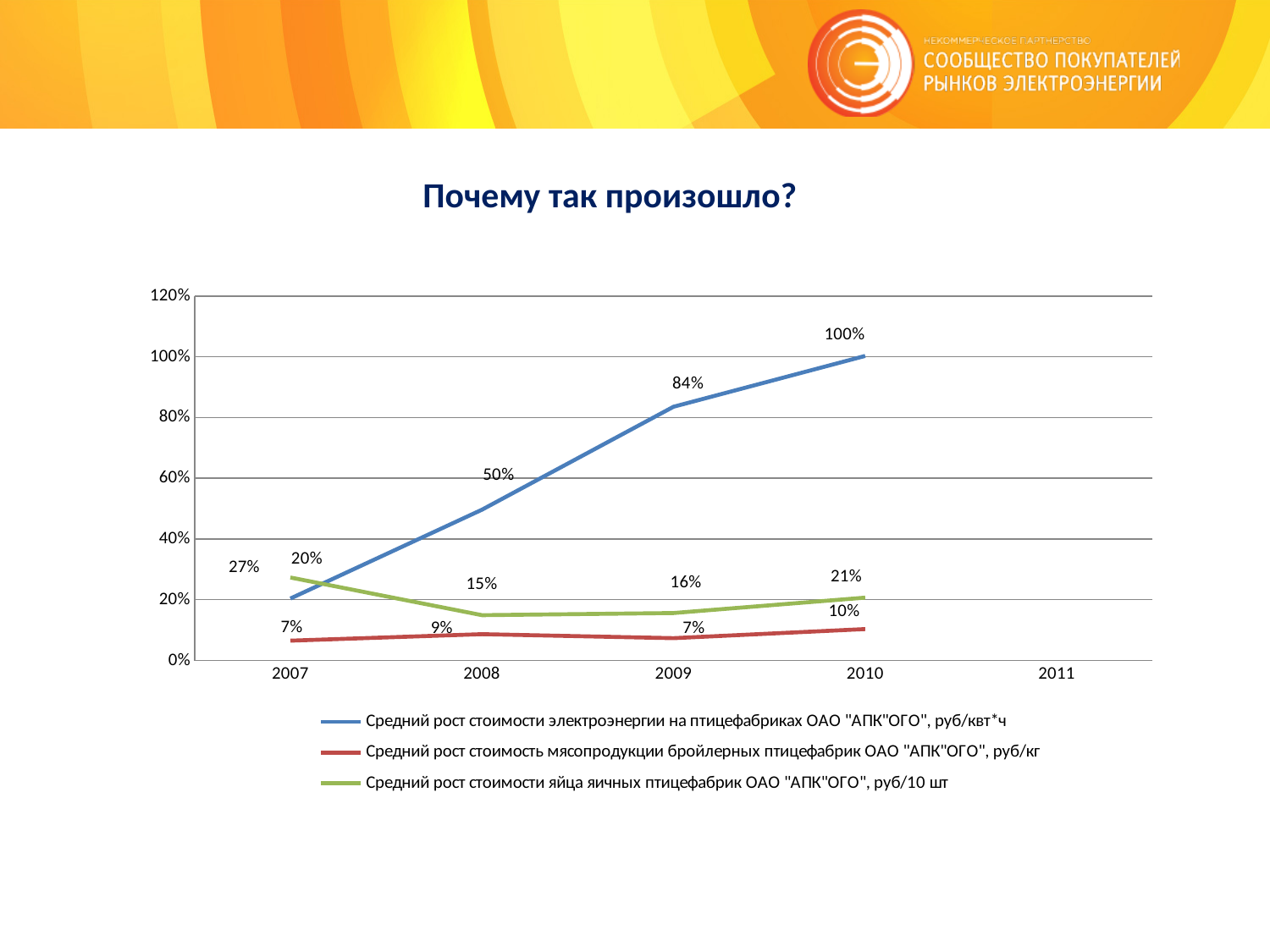
What is the difference between the electricity cost growth value in 2010 and in 2007? 80% Which is larger in 2009: the electricity cost growth value or the egg cost growth value? electricity cost growth (84%) What is the value of the meat product cost growth series (red line) in 2008? 9% What type of chart is shown on the slide? line chart What is the difference between the egg cost growth value and the meat product cost growth value in 2010? 11% What is the value of the egg cost growth series (green line) in 2007? 27% What is the value of the electricity cost growth series (blue line) in 2010? 100% In which year is the egg cost growth series (green line) at its lowest value? 2008 How many series does the legend list? 3 What is the title of the slide above the chart? Почему так произошло? In which year does the electricity cost growth series (blue line) reach its highest value? 2010 Does the electricity cost growth series (blue line) rise or fall from 2007 to 2010? rise